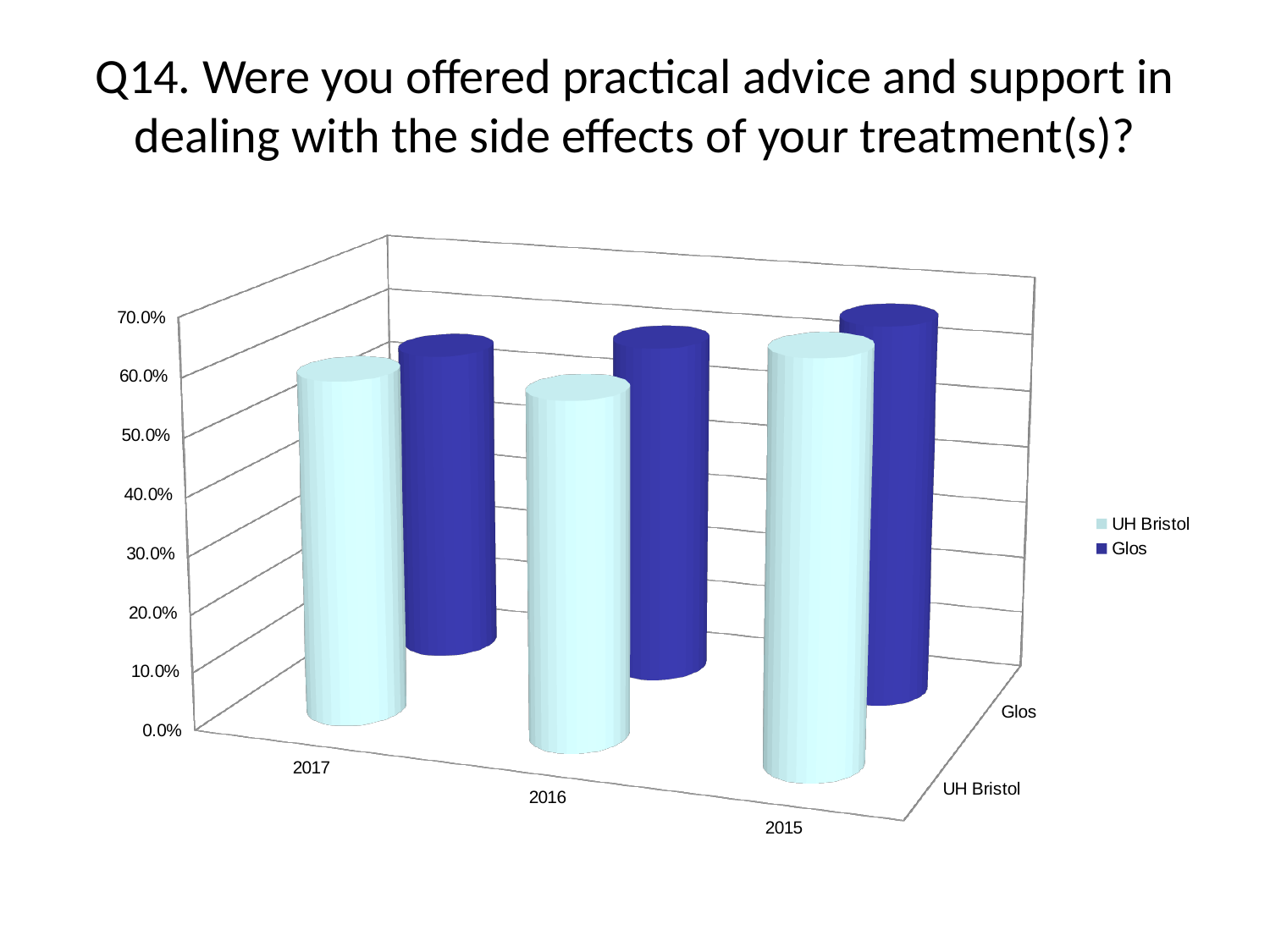
Is the value for UH Bristol in 2016 greater or less than 30%? greater Which series is drawn in dark blue in the chart? Glos Is the value for UH Bristol in 2017 greater or less than 40%? greater Is the value for Glos in 2017 greater or less than 40%? greater How many years are shown on the x axis of the chart? 3 How many series does the chart's legend list? 2 Which two series are listed in the chart's legend? UH Bristol and Glos What kind of chart is shown on the slide? bar chart